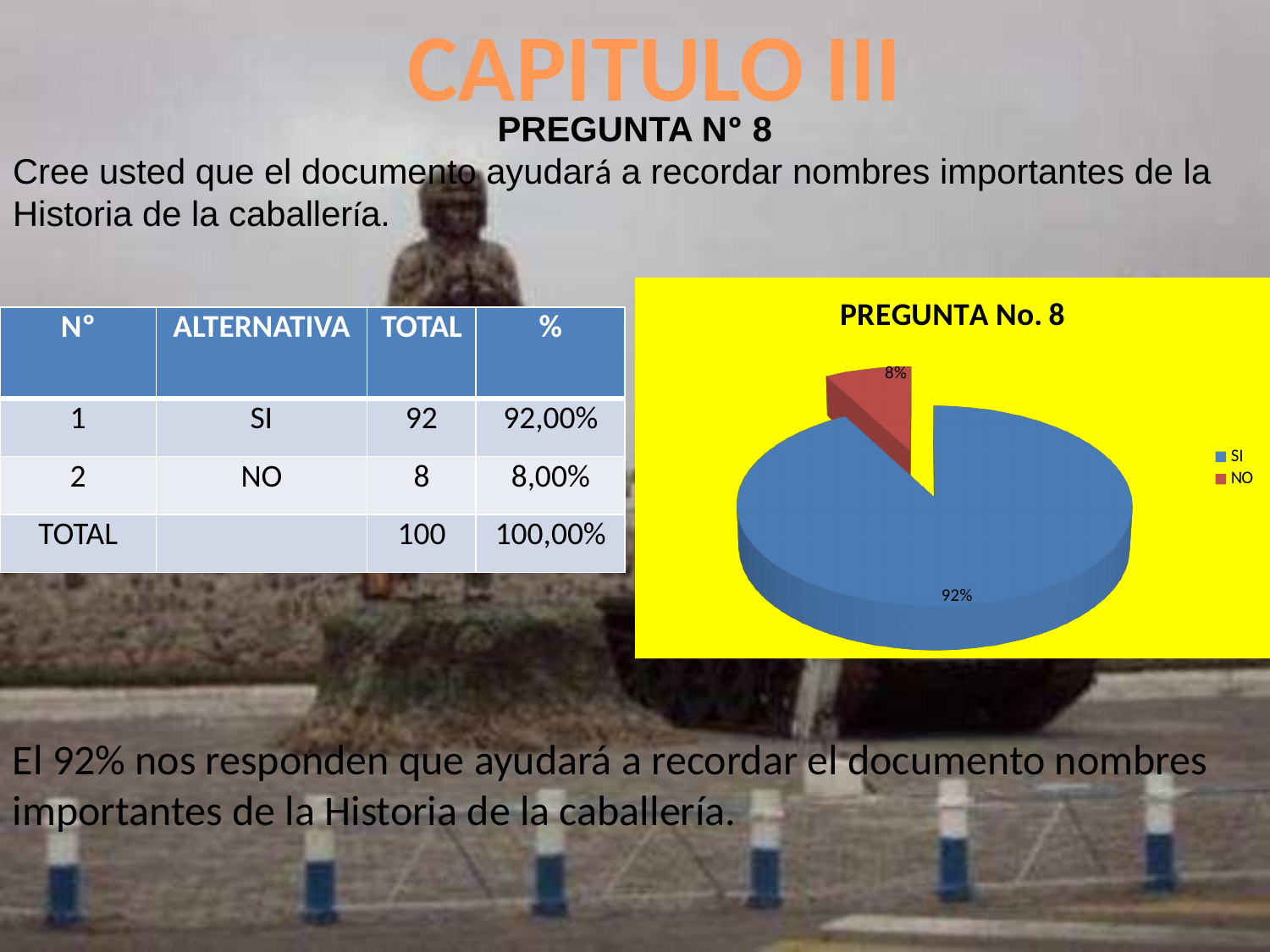
How many entries does the legend list? 2 What share of the pie does the NO slice represent? 8% What colour is the SI slice in the pie chart? blue Which is larger, the SI slice or the NO slice? SI What is the chart's title? PREGUNTA No. 8 What percentage does the NO slice show in the pie chart? 8% Which category has the largest slice in the pie chart? SI What kind of chart is shown on the slide? pie chart How many slices does the pie chart have? 2 Which category has the smallest slice in the pie chart? NO What is the difference in percentage points between the SI and NO slices? 84 What percentage does the SI slice show in the pie chart? 92%